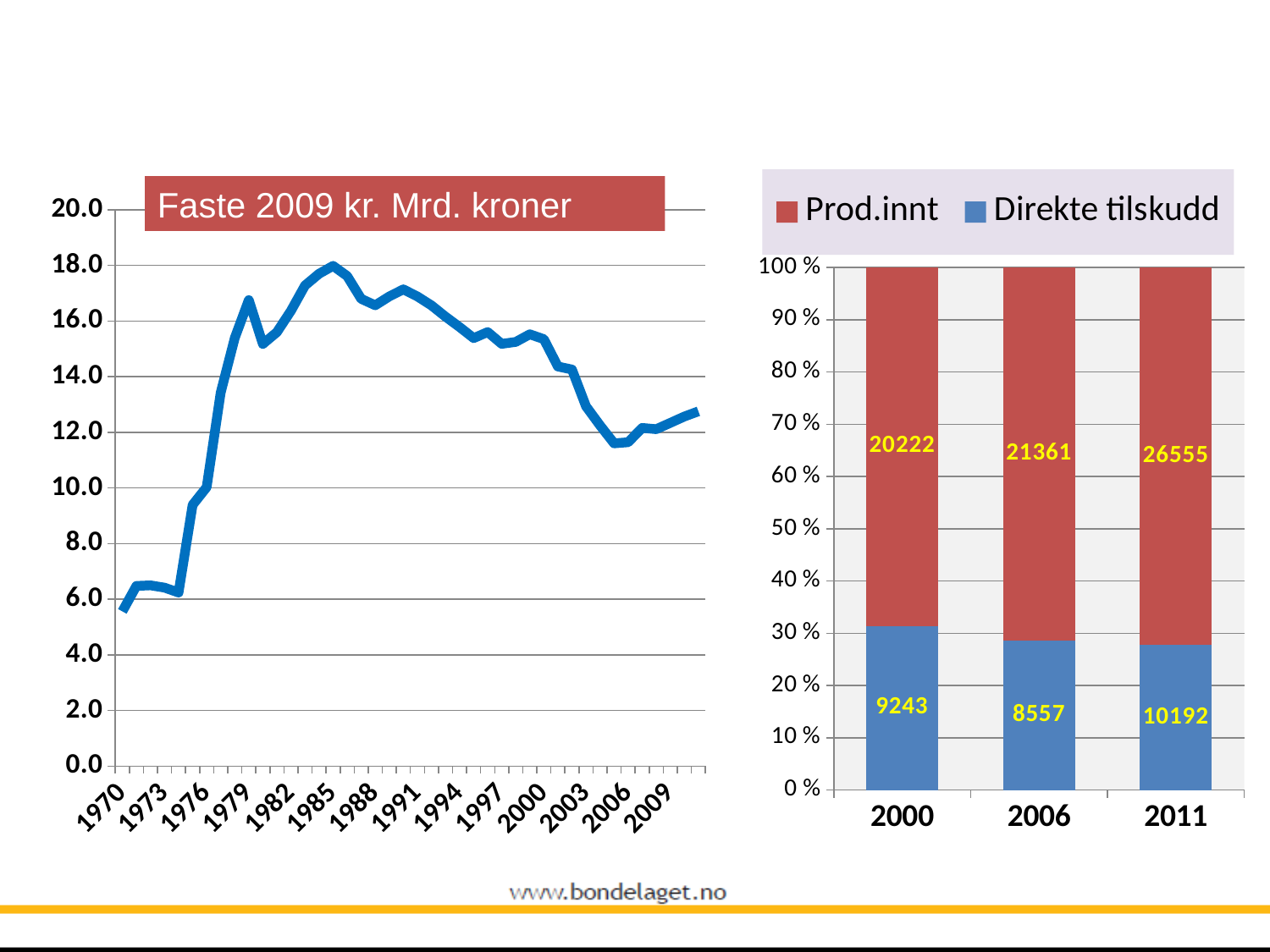
What kind of chart is the left-hand chart titled 'Faste 2009 kr. Mrd. kroner'? line chart In the right-hand stacked bar chart, which year has the highest Prod.innt value? 2011 How many years are shown on the x axis of the right-hand stacked bar chart? 3 In the right-hand stacked bar chart, what is the difference between the Prod.innt values for 2011 and 2000? 6333 In the right-hand stacked bar chart, what is the value of Direkte tilskudd for 2006? 8557 In the right-hand stacked bar chart, what is the value of Prod.innt for 2011? 26555 In the left-hand line chart, does the value rise or fall between 1970 and 1985? rise In the right-hand stacked bar chart, what is the value of Prod.innt for 2000? 20222 In the right-hand stacked bar chart, what is the total of the two values shown for 2000? 29465 In the left-hand line chart, is the value for 1985 greater or less than 16.0? greater In the right-hand stacked bar chart, which year has the lowest Direkte tilskudd value? 2006 How many series does the legend of the right-hand chart list? 2